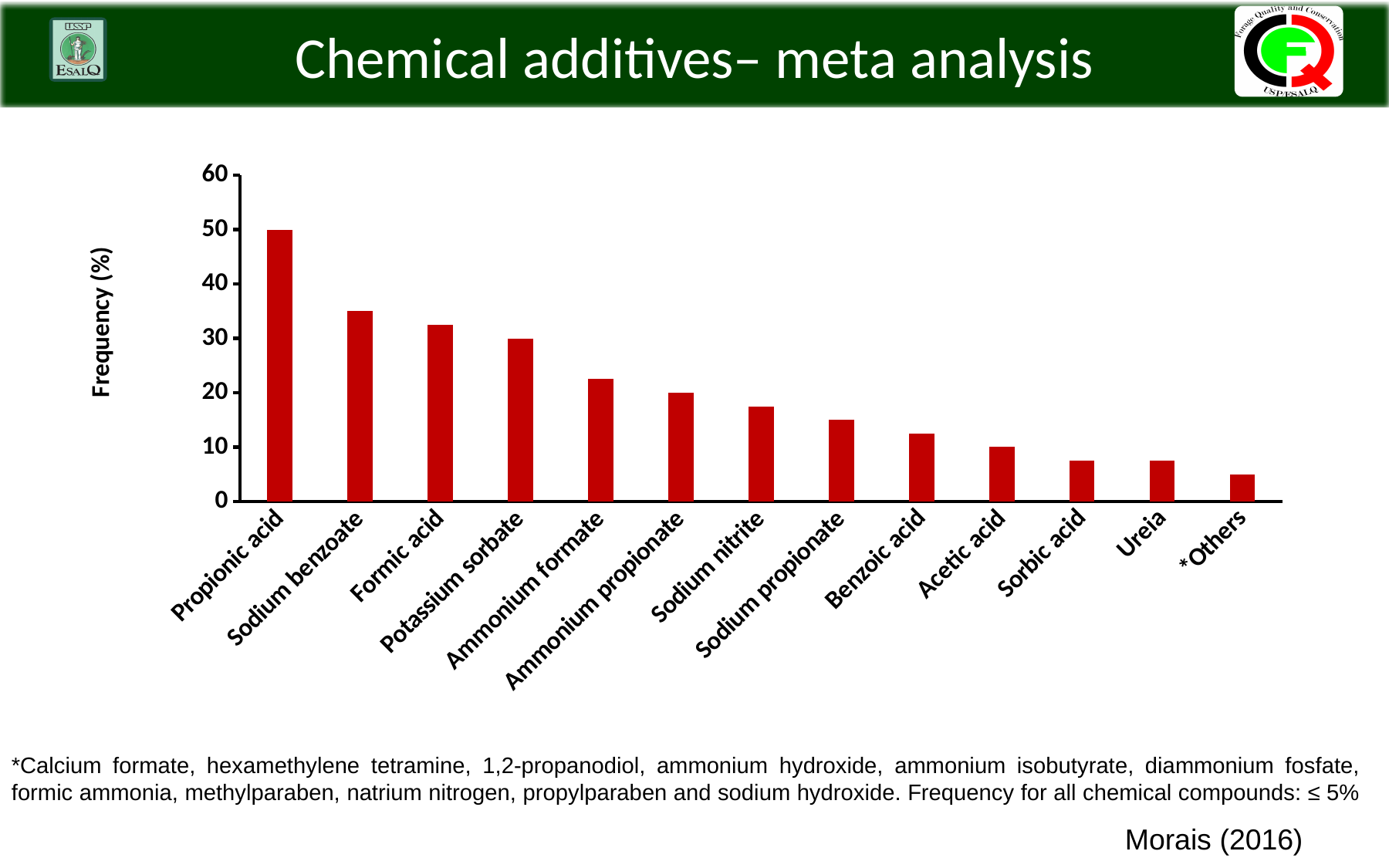
Which chemical additive has the highest frequency? Propionic acid Is the frequency for Sodium nitrite greater or less than 20? less Is the frequency for Propionic acid greater or less than 40? greater Which has a higher frequency, Formic acid or Benzoic acid? Formic acid Is the frequency for Sodium benzoate greater or less than 30? greater Which category has the lowest frequency? *Others What is the label of the y axis? Frequency (%) How many categories are plotted on the x axis? 13 What kind of chart is shown on the slide? bar chart Do the bar values rise or fall from left to right along the x axis? fall What colour are the bars in the chart? red